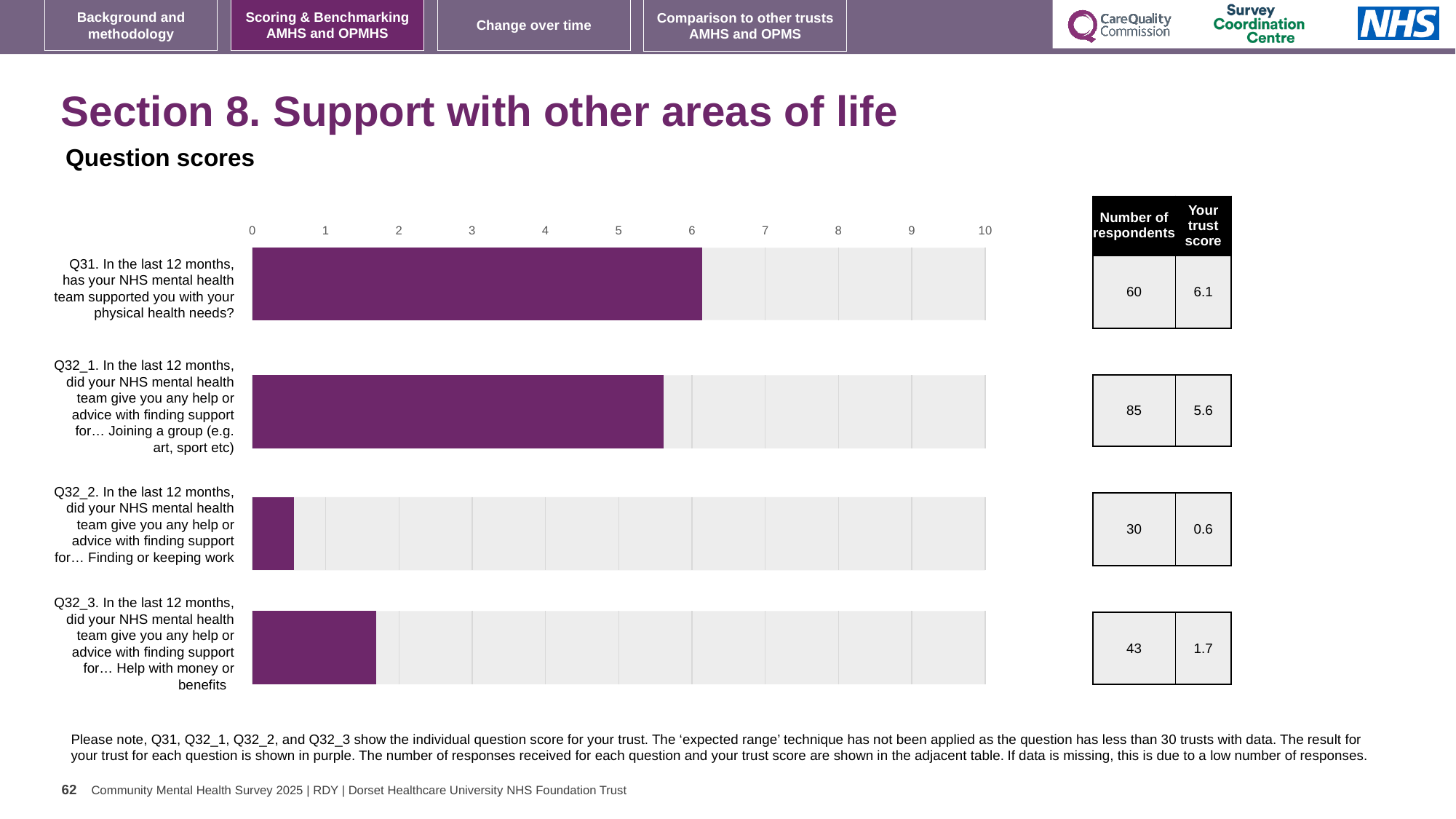
Which question has the highest trust score? Q31 How many questions are plotted in the chart? 4 Which has the larger trust score, Q32_3 or Q32_2? Q32_3 What type of chart is shown on the slide? Bar chart Is the trust score for Q32_1 greater or less than 5? greater What is the trust score for Q32_3 (help with money or benefits)? 1.7 What is the trust score for Q31 (support with physical health needs)? 6.1 What is the difference between the trust scores for Q31 and Q32_1? 0.5 What is the trust score for Q32_2 (help with finding or keeping work)? 0.6 What is the maximum value shown on the chart's axis? 10 How many respondents answered Q32_1 (joining a group)? 85 Which question has the lowest trust score? Q32_2